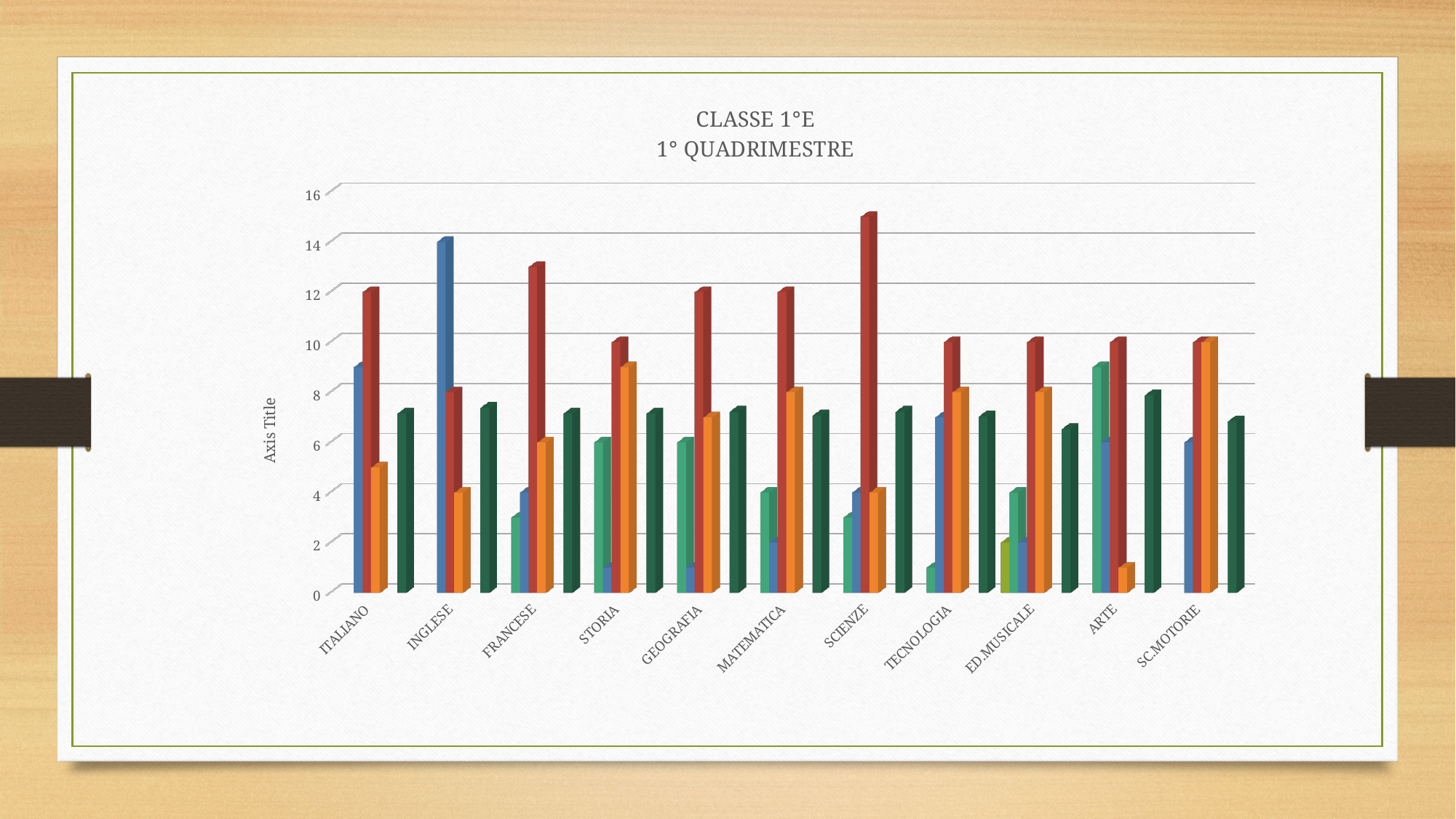
What is the label on the vertical axis? Axis Title Which category has the lowest orange bar? ARTE Is the orange bar for ARTE greater or less than 2? less Is the red bar for FRANCESE greater or less than 12? greater What is the title of the chart? CLASSE 1°E 1° QUADRIMESTRE What kind of chart is shown on the slide? bar chart Which category has the tallest red bar? SCIENZE Is the red bar for SCIENZE greater or less than 14? greater How many subject categories are shown on the x axis? 11 Which is larger, the blue bar for INGLESE or the blue bar for ITALIANO? INGLESE Which category has the lowest red bar? INGLESE